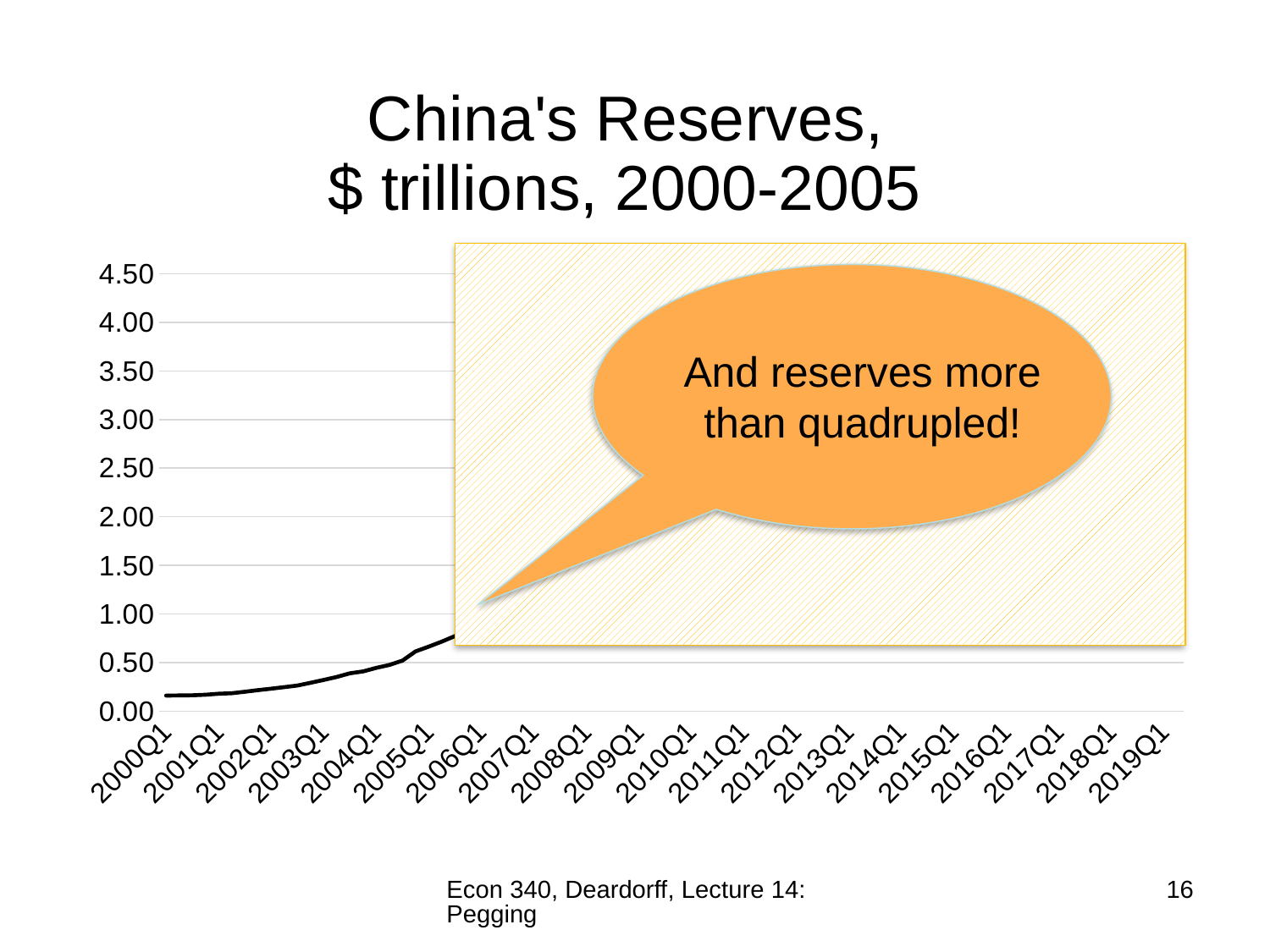
What kind of chart is shown on the slide? line chart Among the visible points on the line, which quarter has the lowest value? 2000Q1 Is the value for 2006Q1 greater or less than 1.00? less Is the value for 2000Q1 greater or less than 0.50? less Which is larger, the value for 2000Q1 or the value for 2006Q1? 2006Q1 What does the callout on the chart say? And reserves more than quadrupled! Is the value for 2006Q1 greater or less than 0.50? greater Does the plotted line rise or fall from 2000Q1 to 2006Q1? rise How many quarter labels are shown on the x axis? 20 What is the title of the chart? China's Reserves, $ trillions, 2000-2005 Which is larger, the value for 2003Q1 or the value for 2005Q1? 2005Q1